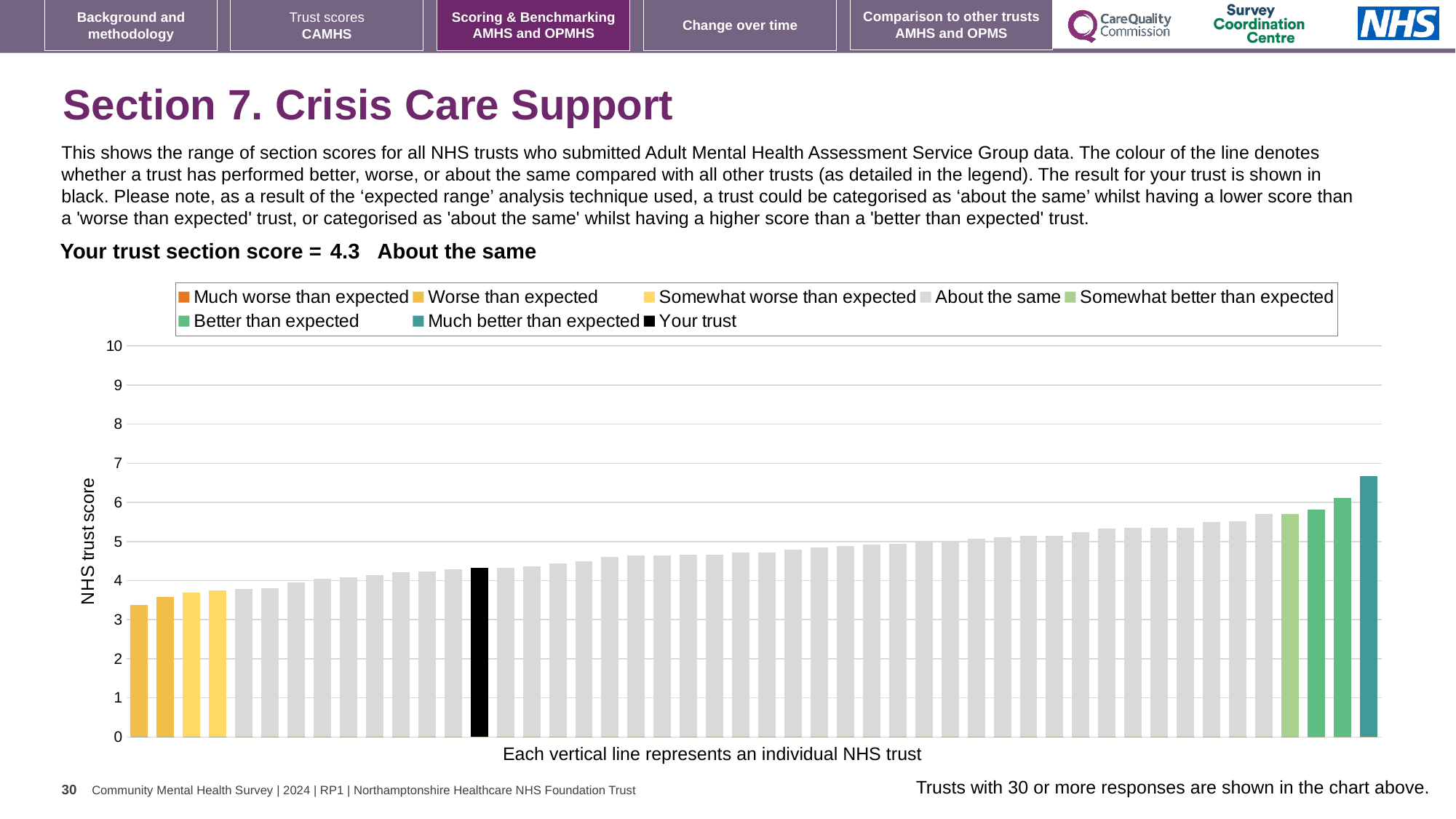
Is the value for your trust (the black bar) greater or less than 4? greater How many entries does the chart legend list? 8 What kind of chart is shown on the slide? bar chart Which legend category does the tallest bar belong to? Much better than expected Do the bar values rise or fall from left to right along the x axis? rise Is the value of the tallest bar greater or less than 6? greater Is the value of the shortest bar greater or less than 4? less Which is larger, the rightmost bar or the black 'Your trust' bar? the rightmost bar What is the title of the vertical axis? NHS trust score How many bars are coloured as 'Much better than expected'? 1 How many bars are coloured as 'Better than expected'? 2 What is the section score for your trust shown on the slide? 4.3